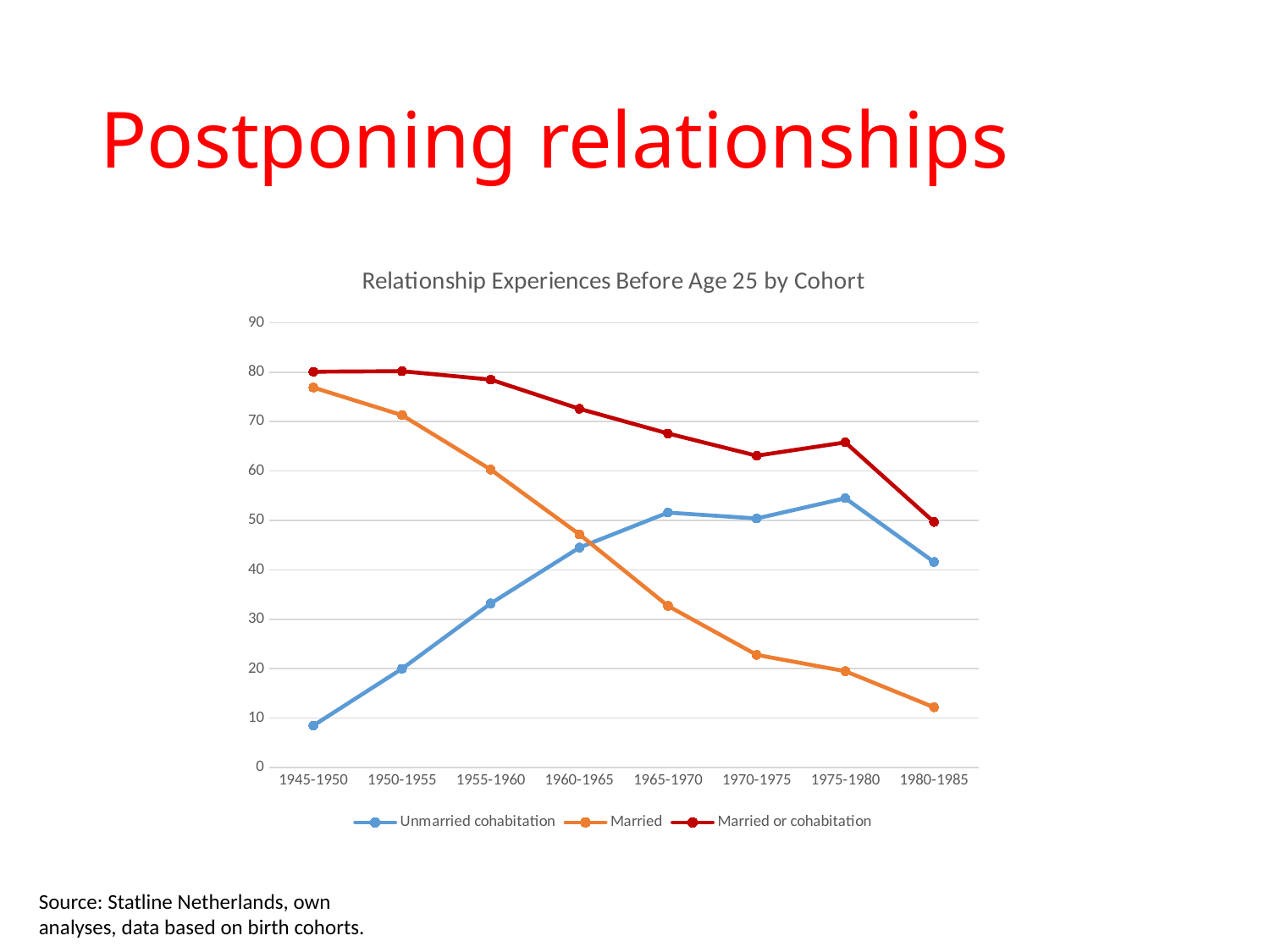
Does the Married series rise or fall across the cohorts from 1945-1950 to 1980-1985? fall Which series is drawn in dark red? Married or cohabitation How many series does the legend list? 3 Which cohort has the highest value for Married? 1945-1950 How many birth cohorts are shown on the x axis? 8 In the 1960-1965 cohort, which is larger: Married or Unmarried cohabitation? Married What type of chart is shown on the slide? line chart Is the value for Married in the 1980-1985 cohort greater or less than 20? less Which cohort has the lowest value for Unmarried cohabitation? 1945-1950 What is the title of the chart? Relationship Experiences Before Age 25 by Cohort Is the value for Unmarried cohabitation in the 1965-1970 cohort greater or less than 50? greater Which cohort has the highest value for Unmarried cohabitation? 1975-1980